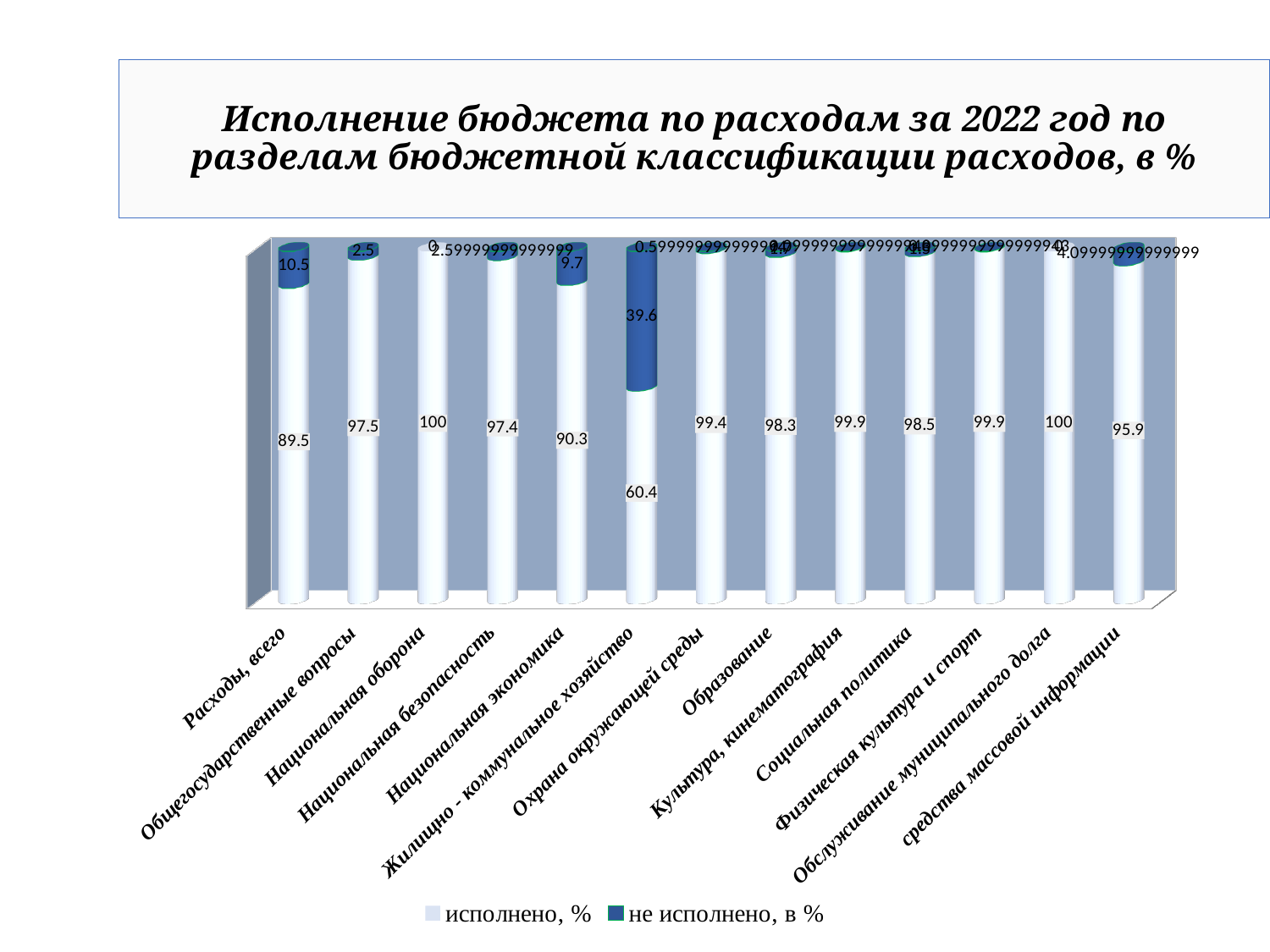
What is the value of "не исполнено, в %" for "Жилищно - коммунальное хозяйство"? 39.6 Which has a higher "исполнено, %" value: "Национальная экономика" or "Образование"? Образование What is the value of "исполнено, %" for "Средства массовой информации"? 95.9 Which category has the lowest value of "исполнено, %"? Жилищно - коммунальное хозяйство How many categories are shown on the x axis of the chart? 13 Which category has the highest value of "не исполнено, в %"? Жилищно - коммунальное хозяйство What is the difference between the "исполнено, %" values for "Общегосударственные вопросы" and "Расходы, всего"? 8 What is the value of "исполнено, %" for "Расходы, всего"? 89.5 What kind of chart is shown on the slide? Stacked bar chart How many series does the legend list? 2 What is the value of "исполнено, %" for "Жилищно - коммунальное хозяйство"? 60.4 What is the value of "не исполнено, в %" for "Национальная экономика"? 9.7